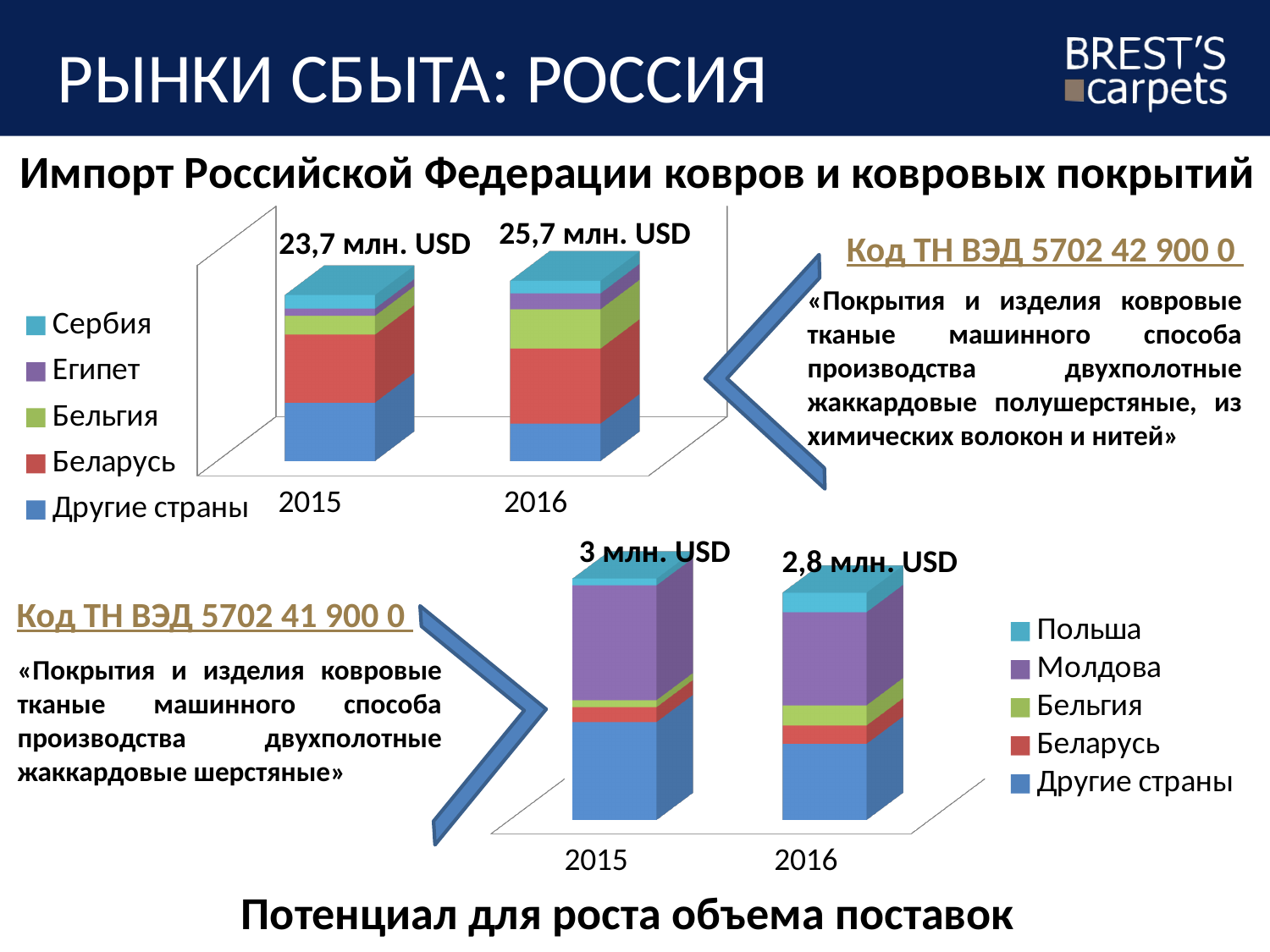
In the top chart, what is the total import value labelled for 2016? 25,7 млн. USD In the top chart, which year has the higher total import value? 2016 In the bottom chart, which year has the lower total value? 2016 In the bottom chart, what is the total value labelled for 2016? 2,8 млн. USD In the bottom chart, what is the difference between the 2015 and 2016 totals? 0,2 млн. USD In the bottom chart, do the totals rise or fall from 2015 to 2016? fall How many series does the legend of the top chart list? 5 In the top chart, what is the total import value labelled for 2015? 23,7 млн. USD In the top chart, by how much does the 2016 total exceed the 2015 total? 2 млн. USD What type of chart is the bottom chart? stacked bar chart In the bottom chart, what is the total value labelled for 2015? 3 млн. USD In the bottom chart, which country is shown in purple according to the legend? Молдова